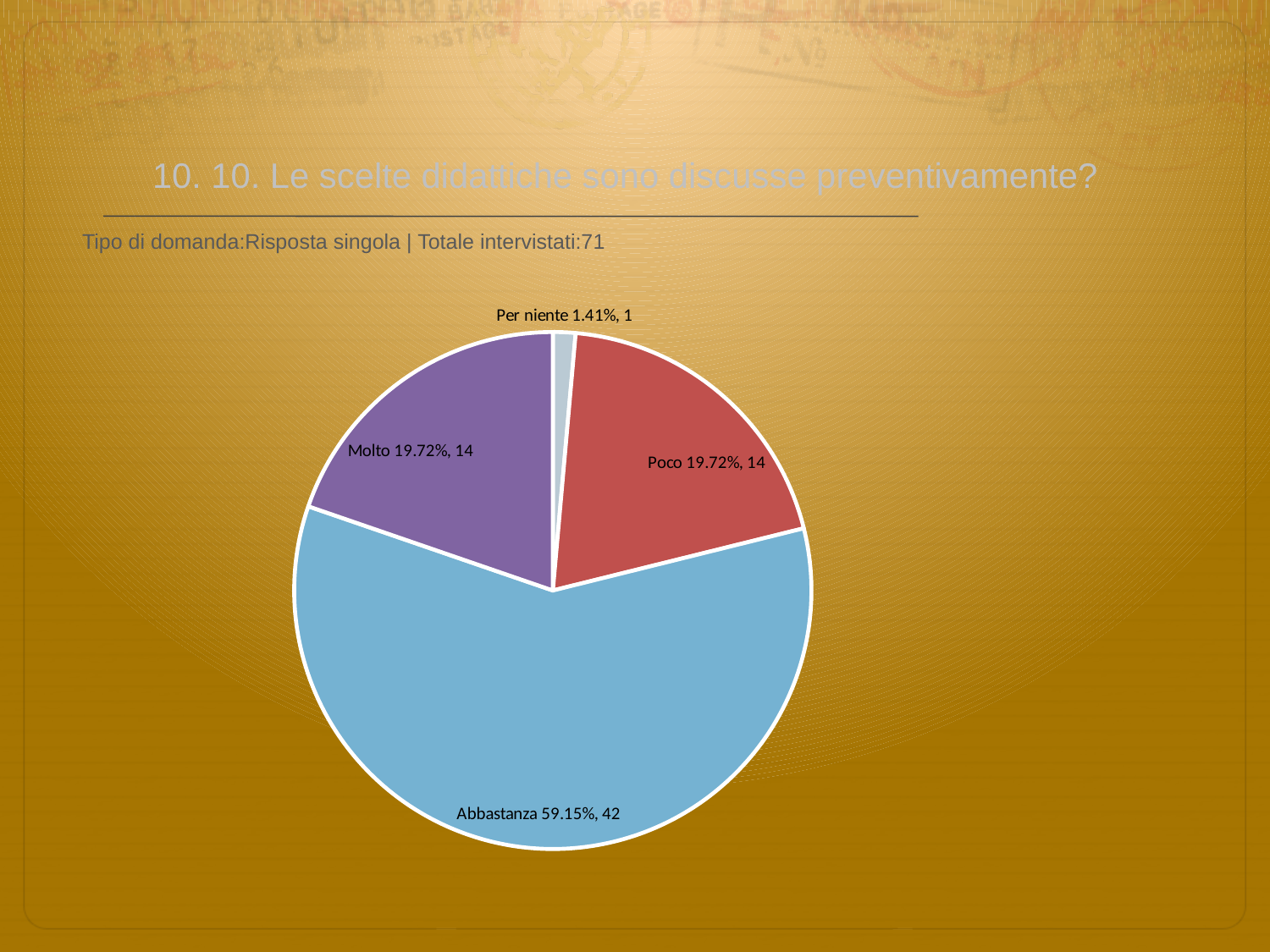
Which category has the smallest slice? Per niente What kind of chart is shown on the slide? pie chart How many slices does the pie chart have? 4 What percentage share does the Abbastanza slice have? 59.15% What percentage share does the Poco slice have? 19.72% What is the difference in respondent count between Abbastanza and Molto? 28 How many respondents answered Per niente? 1 Which category has the largest slice? Abbastanza What colour is the Abbastanza slice? light blue What is the total number of respondents stated on the slide? 71 Which is larger, the Abbastanza slice or the Poco slice? Abbastanza How many respondents answered Abbastanza? 42